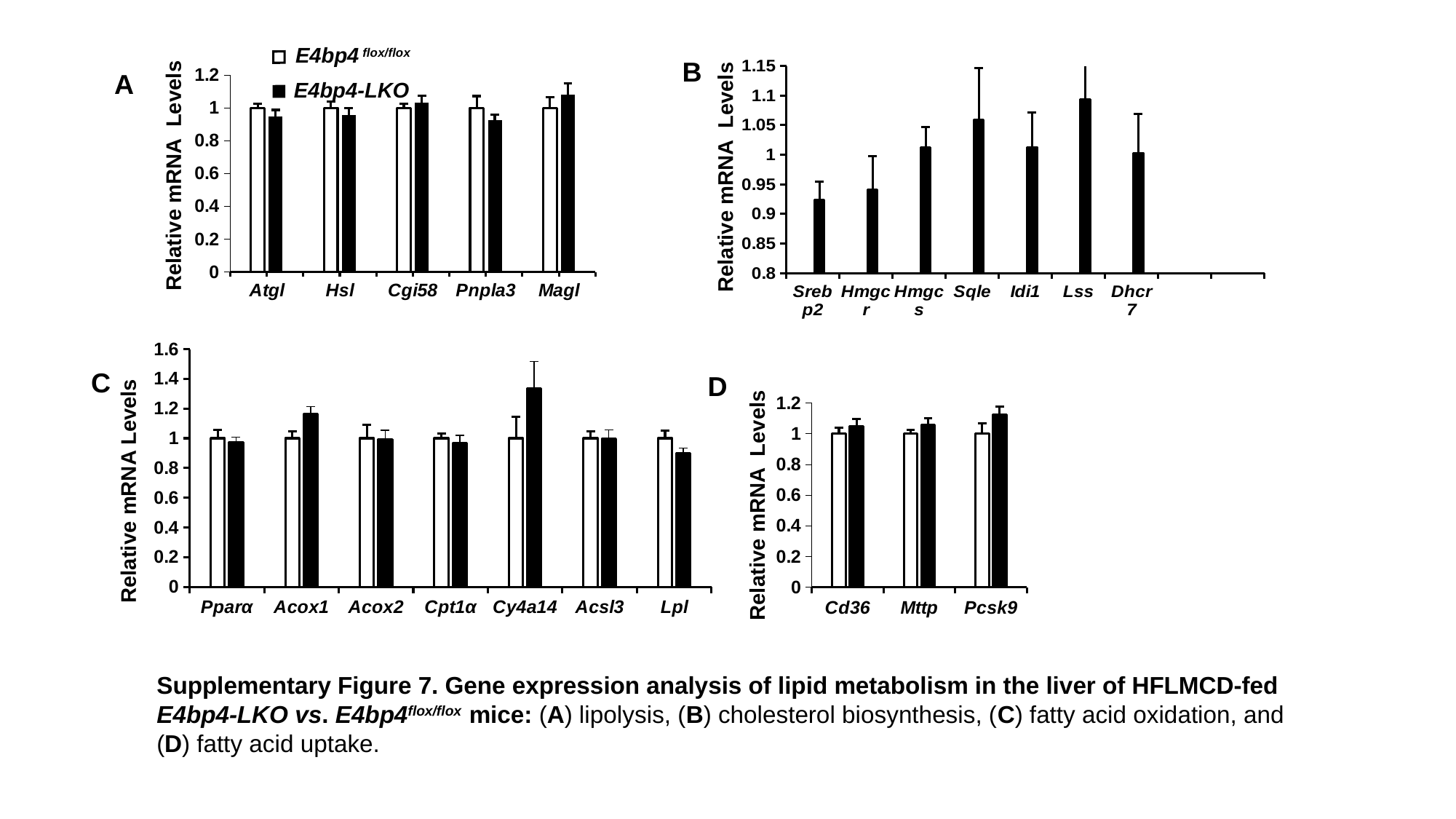
In chart A (top left), is the E4bp4-LKO value for Magl greater or less than 1? greater In chart B (top right), is the value for Sqle greater or less than 1? greater In chart B (top right), how many genes are shown on the x axis? 7 In chart D (bottom right), how many genes are shown on the x axis? 3 What type of chart is chart D (bottom right)? bar chart In chart B (top right), which gene has the highest relative mRNA level? Lss In chart A (top left), how many genes are shown on the x axis? 5 In chart C (bottom left), is the E4bp4-LKO value for Lpl greater or less than 1? less In chart A (top left), how many series does the legend list? 2 In chart A (top left), what is the relative mRNA level of E4bp4 flox/flox for Atgl? 1 In chart C (bottom left), which gene has the highest E4bp4-LKO relative mRNA level? Cy4a14